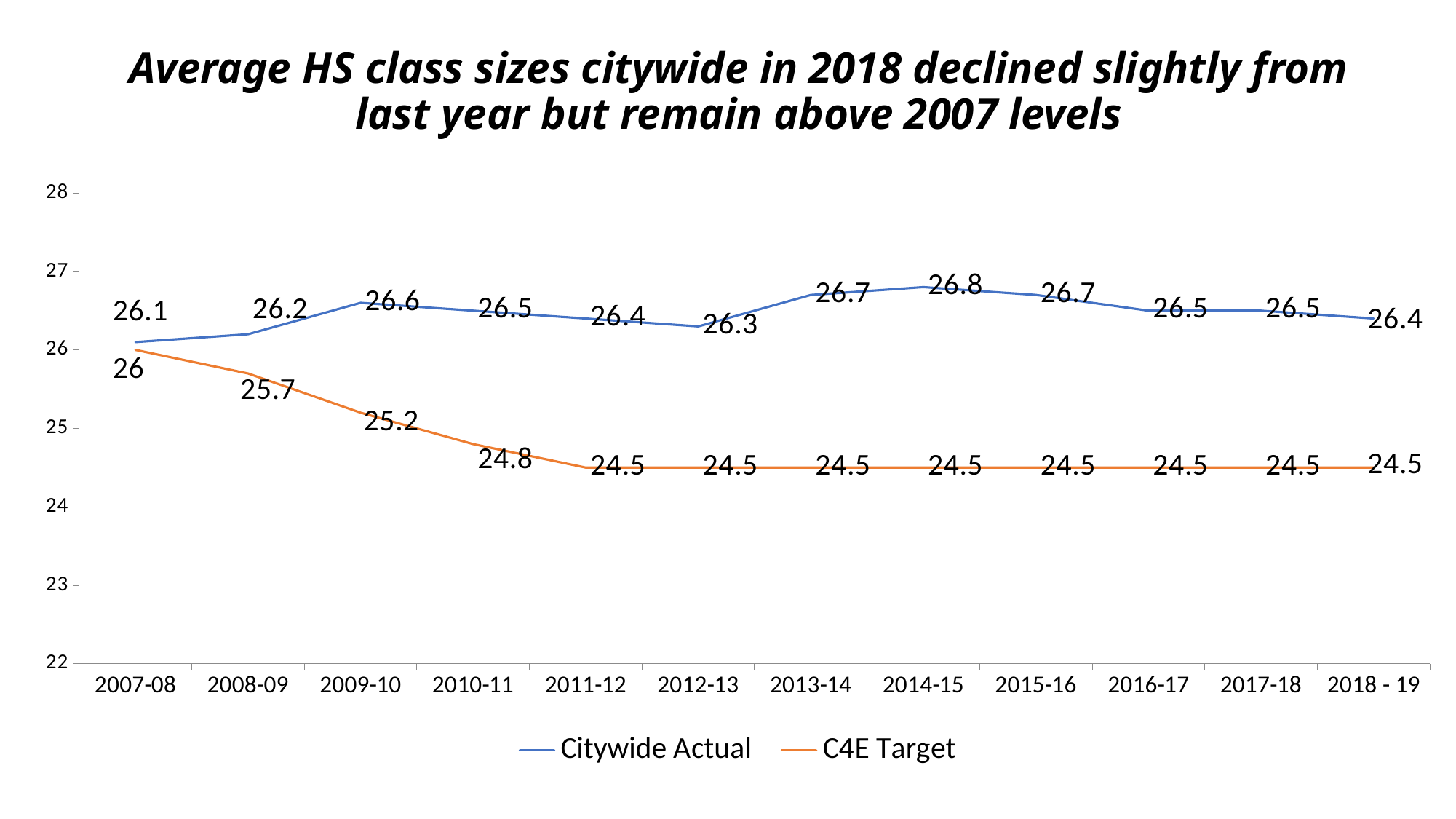
What is the C4E Target value for 2009-10? 25.2 What is the Citywide Actual value for 2018 - 19? 26.4 How many years are shown on the x axis? 12 In which year does the Citywide Actual series reach its highest value? 2014-15 Does the C4E Target series rise or fall from 2007-08 to 2011-12? Fall What kind of chart is this? Line chart What is the Citywide Actual value for 2014-15? 26.8 Which is larger in 2008-09, Citywide Actual or C4E Target? Citywide Actual What colour is the C4E Target line? Orange In which year is the Citywide Actual value lowest? 2007-08 How many series does the legend list? 2 What is the difference between the Citywide Actual and C4E Target values in 2018 - 19? 1.9